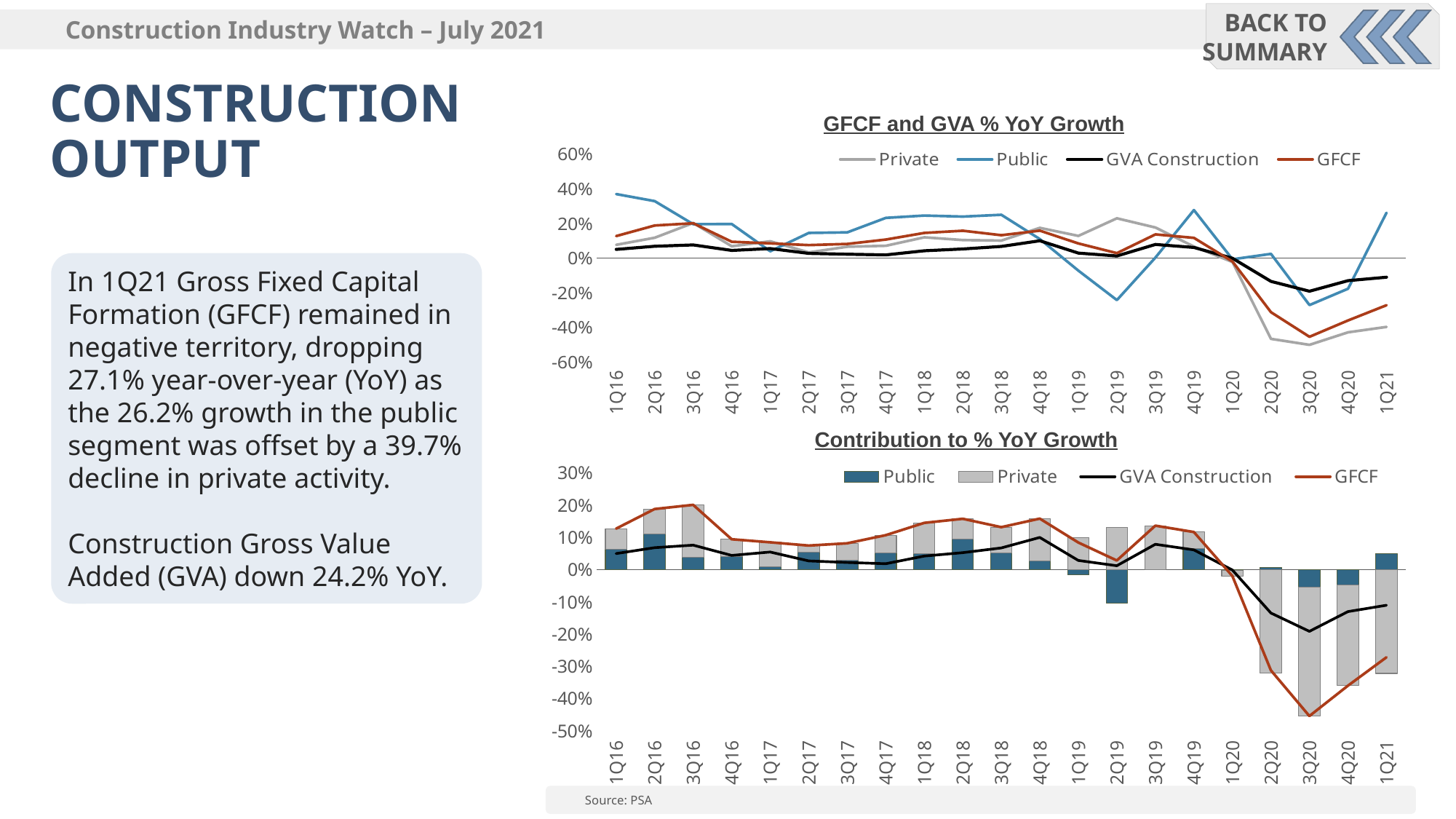
In the 'GFCF and GVA % YoY Growth' chart, does the GFCF line rise or fall from 1Q20 to 3Q20? fall How many quarters are shown on the x axis of the 'Contribution to % YoY Growth' chart? 21 In the 'GFCF and GVA % YoY Growth' chart, is the Public value for 1Q16 greater or less than 20%? greater In the 'GFCF and GVA % YoY Growth' chart, how many series does the legend list? 4 In the 'GFCF and GVA % YoY Growth' chart, in which quarter does the Public line reach its highest value? 1Q16 In the 'Contribution to % YoY Growth' chart, in which quarter is the Private bar lowest? 3Q20 What kind of chart is the 'GFCF and GVA % YoY Growth' chart? Line chart In the 'GFCF and GVA % YoY Growth' chart, is the Private value for 3Q20 greater or less than -40%? less In the 'Contribution to % YoY Growth' chart, which series are shown as bars? Public and Private In the 'Contribution to % YoY Growth' chart, which is larger in 1Q21: the Public bar or the Private bar? Public In the 'GFCF and GVA % YoY Growth' chart, in which quarter does the GFCF line reach its lowest value? 3Q20